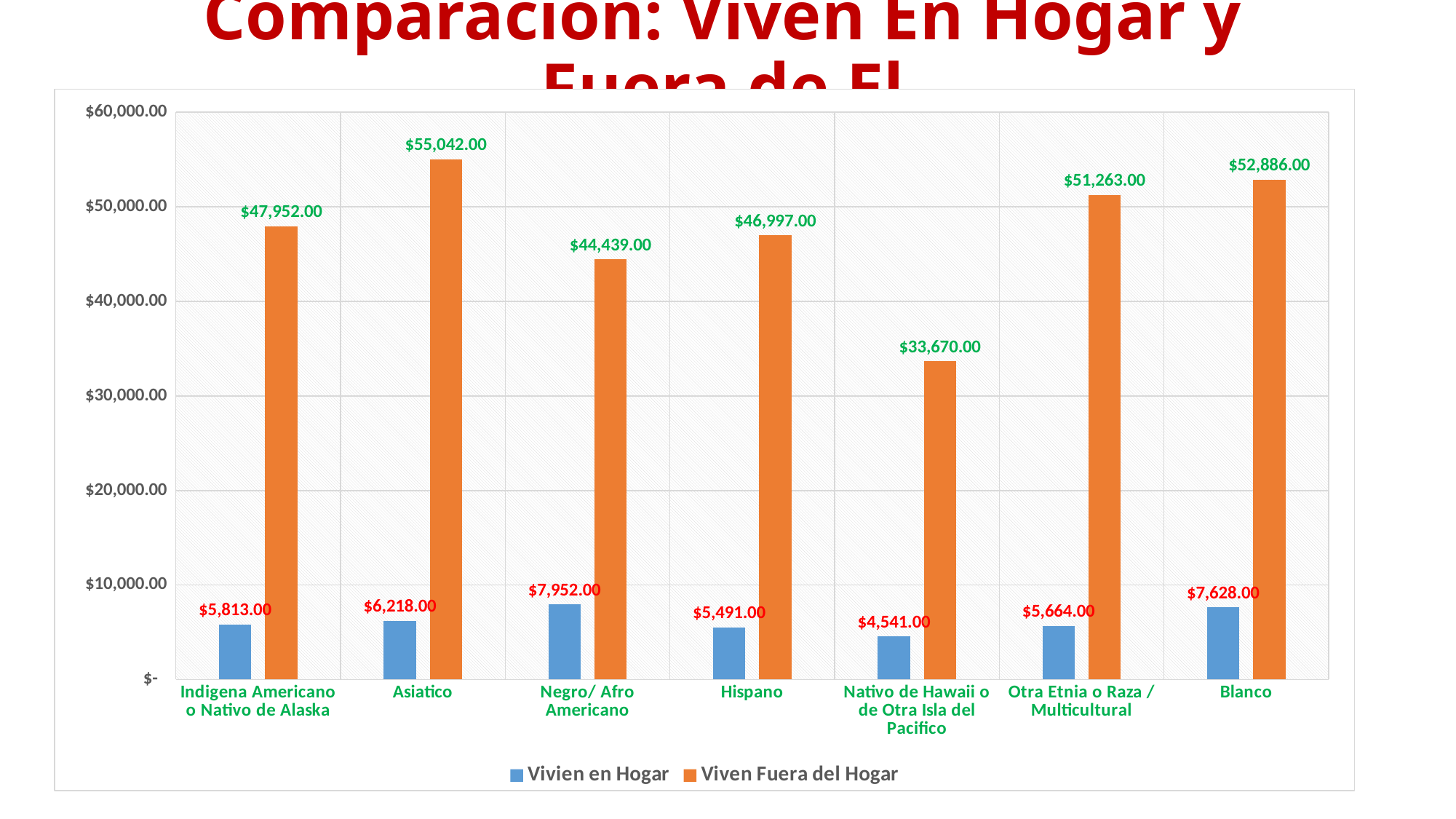
What kind of chart is shown on the slide? Bar chart What is the Viven Fuera del Hogar value for Nativo de Hawaii o de Otra Isla del Pacifico? $33,670.00 Which category has the highest Viven Fuera del Hogar value? Asiatico How many series does the legend list? 2 How many categories are shown on the x axis? 7 What is the difference between the Viven Fuera del Hogar and Vivien en Hogar values for Blanco? $45,258.00 Is the Viven Fuera del Hogar value for Negro/ Afro Americano greater or less than $40,000.00? greater Which is larger: the Viven Fuera del Hogar value for Otra Etnia o Raza / Multicultural or for Hispano? Otra Etnia o Raza / Multicultural Which category has the lowest Vivien en Hogar value? Nativo de Hawaii o de Otra Isla del Pacifico What is the value for Hispano in the Vivien en Hogar series? $5,491.00 What is the value for Asiatico in the Viven Fuera del Hogar series? $55,042.00 Which category has the highest Vivien en Hogar value? Negro/ Afro Americano